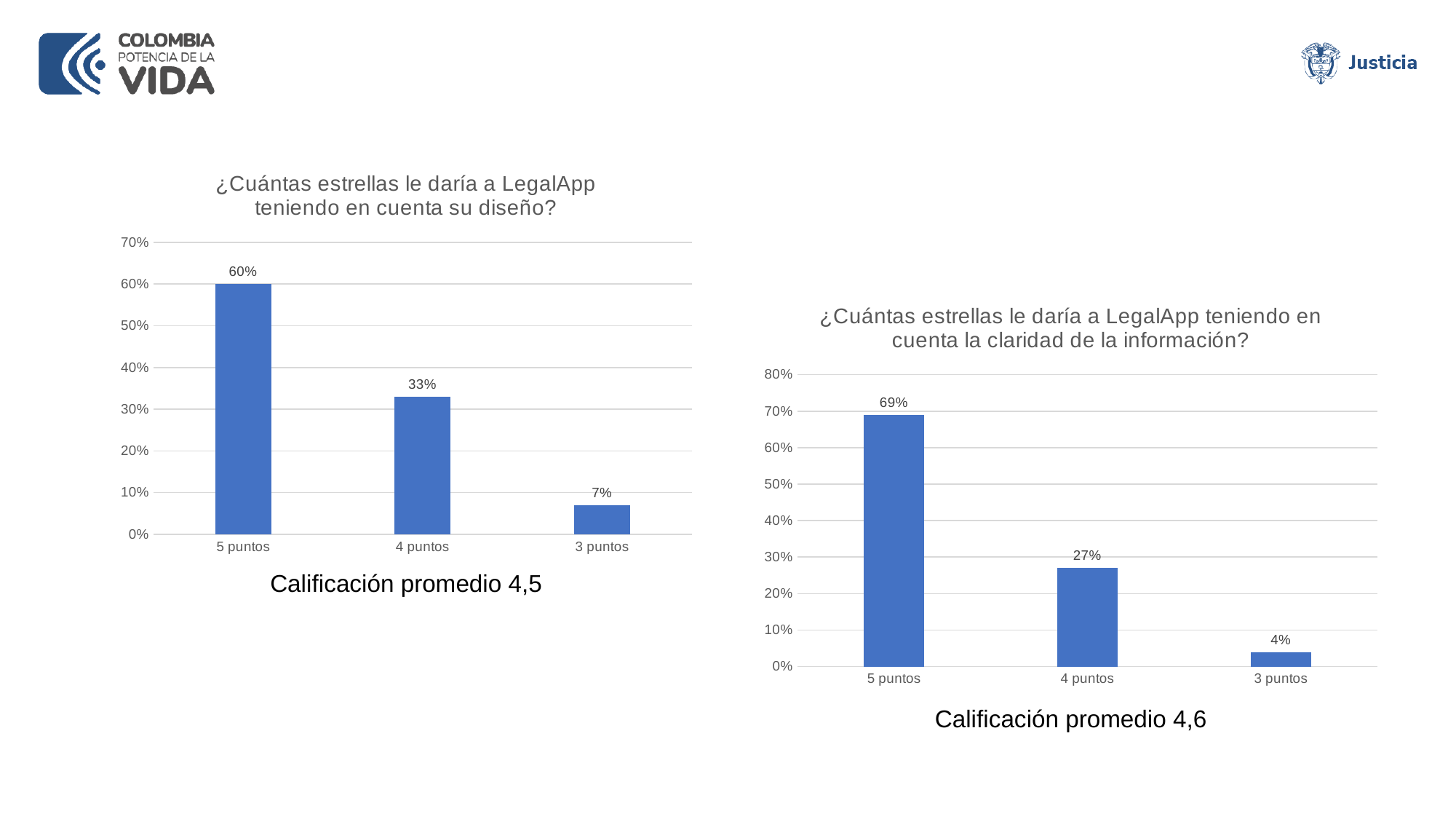
In the right chart (clarity of information rating), which category has the highest value? 5 puntos In the right chart (clarity of information rating), what percentage of respondents gave 3 puntos? 4% In the right chart (clarity of information rating), what is the difference between the 5 puntos and 3 puntos values? 65% In the left chart (design rating), what percentage of respondents gave 5 puntos? 60% In the left chart (design rating), which category has the lowest value? 3 puntos In the right chart (clarity of information rating), do the values rise or fall from 5 puntos to 3 puntos? Fall What type of chart is the right chart (clarity of information rating)? Bar chart How many categories are shown on the x axis of the left chart (design rating)? 3 In the right chart (clarity of information rating), what percentage of respondents gave 4 puntos? 27% Which is larger: the 5 puntos value in the left chart (design) or the 5 puntos value in the right chart (clarity of information)? Right chart (clarity of information), 69% In the left chart (design rating), what is the difference between the 5 puntos and 4 puntos values? 27% In the left chart (design rating), what percentage of respondents gave 3 puntos? 7%